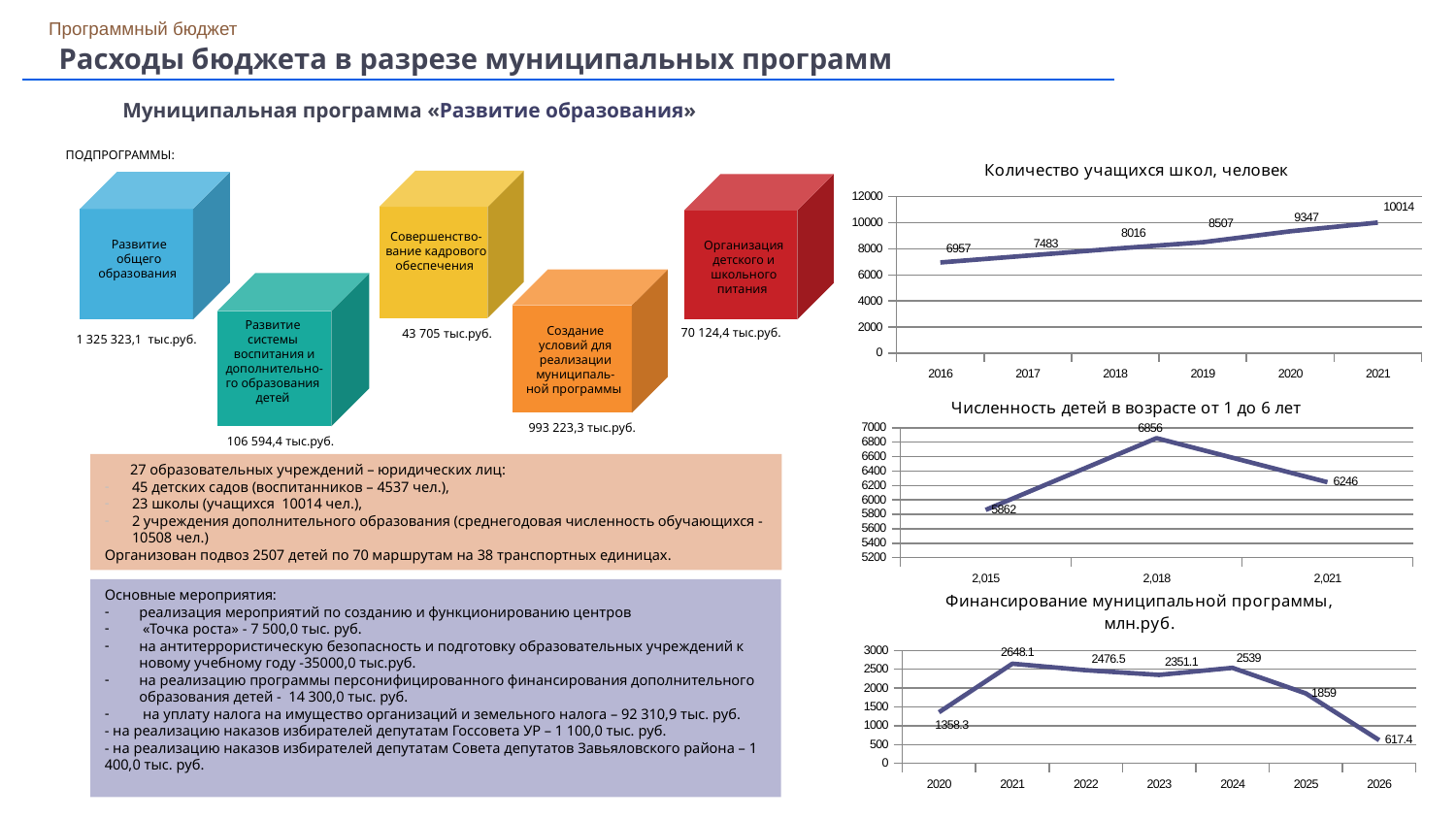
In the chart 'Численность детей в возрасте от 1 до 6 лет', what is the difference between the values for 2018 and 2021? 610 In the chart 'Количество учащихся школ, человек', what is the difference between the values for 2021 and 2016? 3057 In the chart 'Численность детей в возрасте от 1 до 6 лет', what is the value for 2018? 6856 In the chart 'Финансирование муниципальной программы, млн.руб.', what is the value for 2025? 1859 In the chart 'Количество учащихся школ, человек', do the values rise or fall from 2016 to 2021? rise In the chart 'Численность детей в возрасте от 1 до 6 лет', which year has the lowest value? 2015 What type of chart is 'Финансирование муниципальной программы, млн.руб.'? line chart How many data points are plotted in the chart 'Количество учащихся школ, человек'? 6 In the chart 'Количество учащихся школ, человек', what is the value for 2018? 8016 In the chart 'Финансирование муниципальной программы, млн.руб.', which is larger: the value for 2022 or the value for 2024? 2024 In the chart 'Финансирование муниципальной программы, млн.руб.', which year has the highest value? 2021 In the chart 'Количество учащихся школ, человек', which year has the highest value? 2021